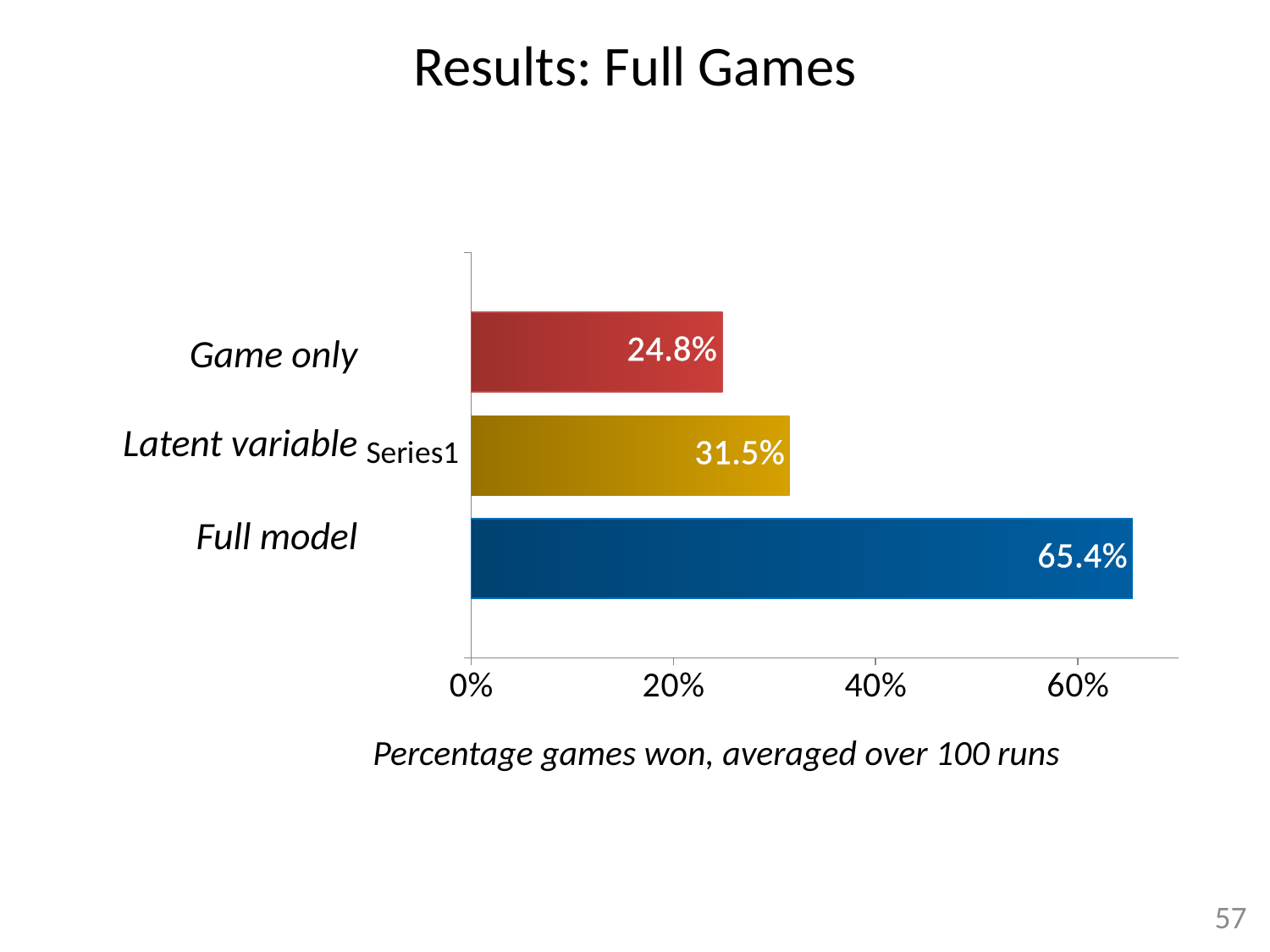
What is the difference between the values for Latent variable and Game only? 6.7% What is the difference between the values for Full model and Game only? 40.6% Which category has the lowest value? Game only What is the label shown below the horizontal axis of the chart? Percentage games won, averaged over 100 runs What is the value for Full model? 65.4% Which is larger, the value for Latent variable or the value for Game only? Latent variable What is the value for Latent variable? 31.5% How many categories are shown in the chart? 3 What kind of chart is shown on the slide? bar chart What is the value for Game only? 24.8% Is the value for Full model greater or less than 60%? greater Which category has the highest value? Full model